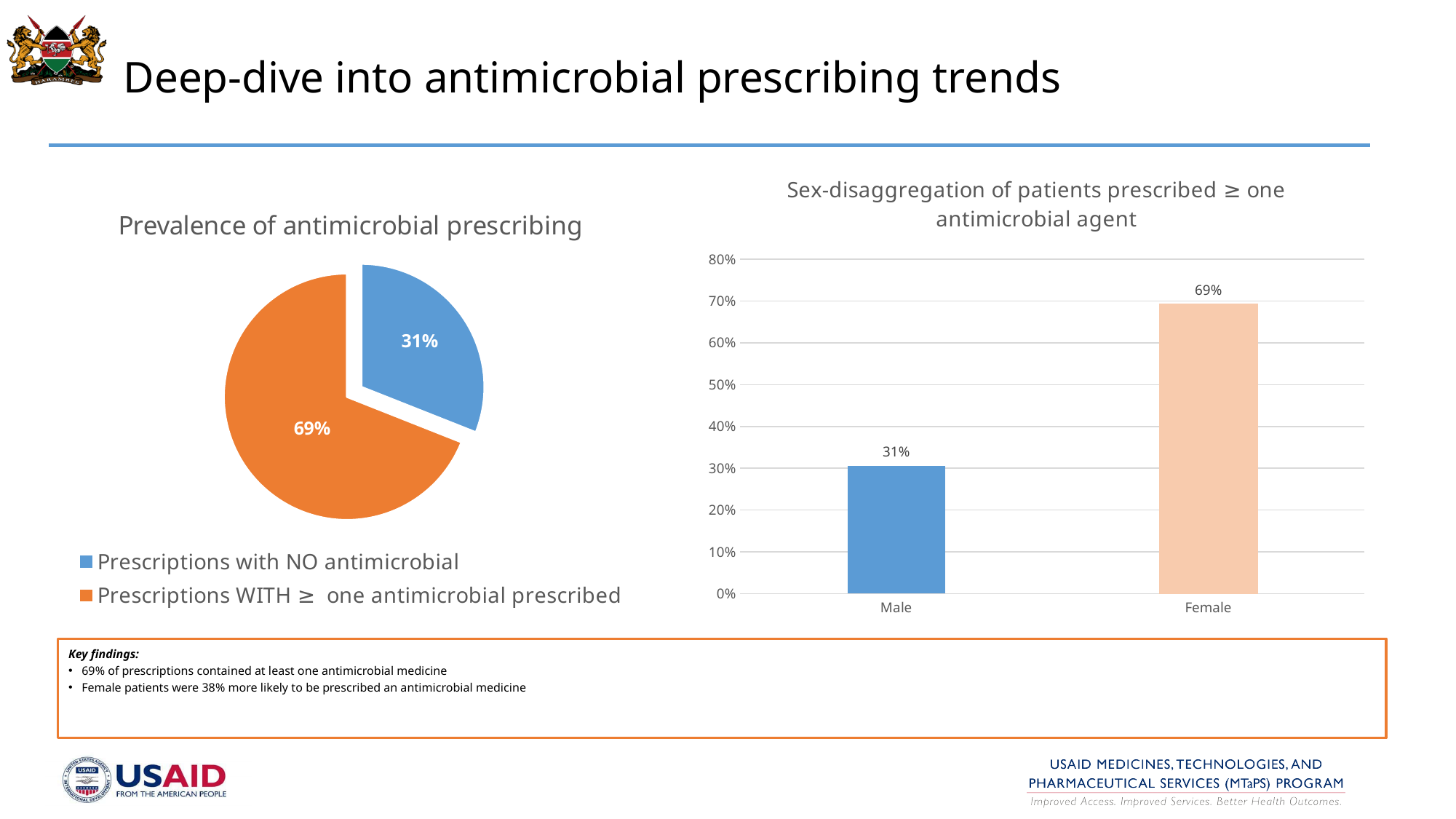
What kind of chart is the 'Prevalence of antimicrobial prescribing' chart? Pie chart In the 'Sex-disaggregation of patients prescribed ≥ one antimicrobial agent' chart, what is the difference between the Female and Male values? 38% In the 'Sex-disaggregation of patients prescribed ≥ one antimicrobial agent' chart, what is the value for Female? 69% What kind of chart is the 'Sex-disaggregation of patients prescribed ≥ one antimicrobial agent' chart? Bar chart In the 'Prevalence of antimicrobial prescribing' chart, what share of prescriptions had at least one antimicrobial prescribed? 69% In the 'Sex-disaggregation of patients prescribed ≥ one antimicrobial agent' chart, which category has the highest value? Female How many slices does the 'Prevalence of antimicrobial prescribing' pie chart have? 2 In the 'Prevalence of antimicrobial prescribing' chart, which slice is larger: prescriptions with NO antimicrobial or prescriptions WITH at least one antimicrobial? Prescriptions WITH ≥ one antimicrobial prescribed In the 'Prevalence of antimicrobial prescribing' chart, what colour is the slice for prescriptions with NO antimicrobial? Blue In the 'Prevalence of antimicrobial prescribing' chart, what share of prescriptions had NO antimicrobial? 31% In the 'Sex-disaggregation of patients prescribed ≥ one antimicrobial agent' chart, is the value for Female greater or less than 60%? greater In the 'Sex-disaggregation of patients prescribed ≥ one antimicrobial agent' chart, what is the value for Male? 31%